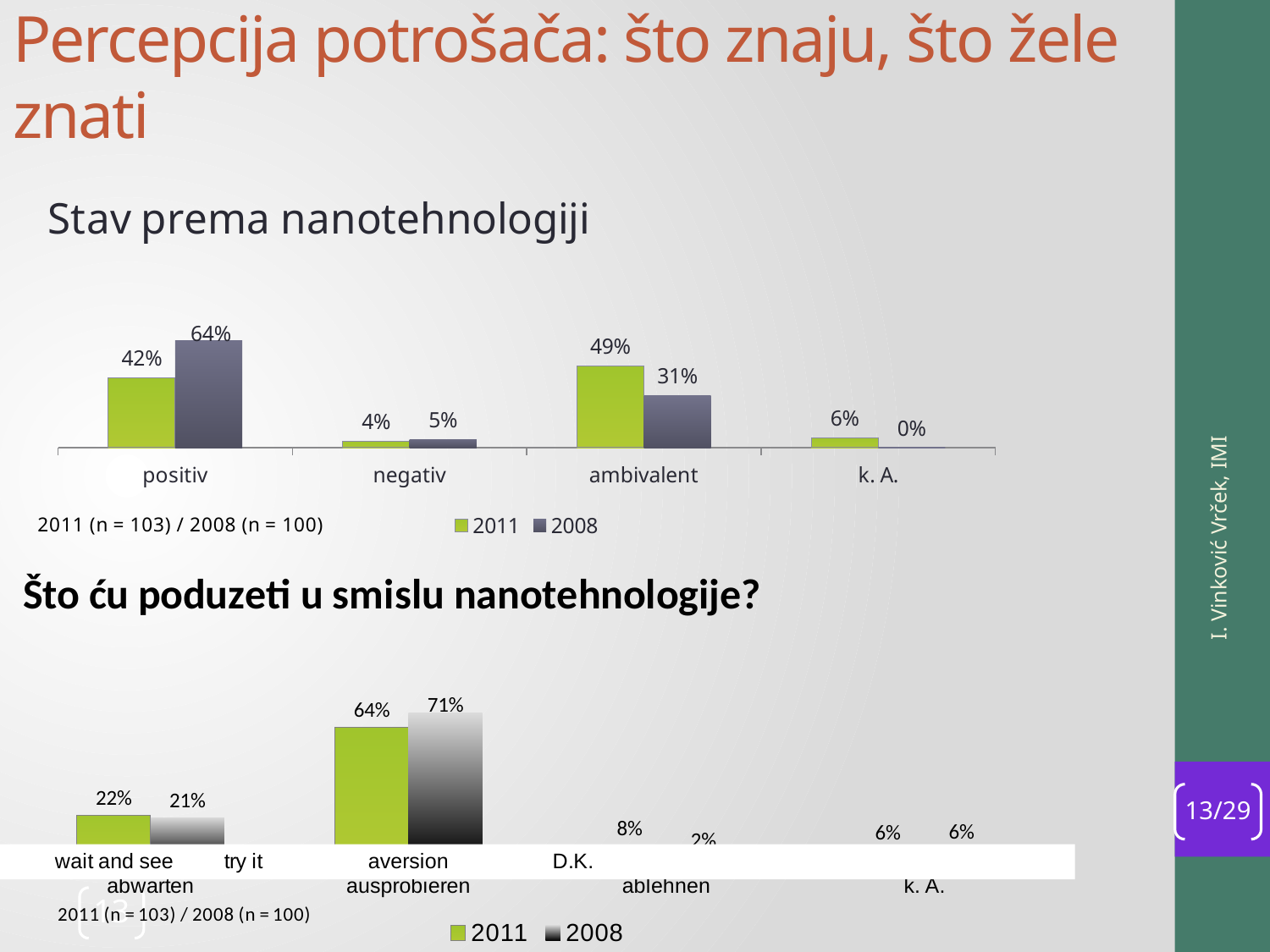
In the bottom chart (Što ću poduzeti u smislu nanotehnologije?), what is the 2008 value for ausprobieren (try it)? 71% In the top chart (Stav prema nanotehnologiji), what is the 2011 value for positiv? 42% In the top chart (Stav prema nanotehnologiji), how many categories are shown on the x axis? 4 In the top chart (Stav prema nanotehnologiji), which category has the highest 2008 value? positiv In the top chart (Stav prema nanotehnologiji), is the 2011 or the 2008 value larger for ambivalent? 2011 In the bottom chart (Što ću poduzeti u smislu nanotehnologije?), what is the difference between the 2008 and 2011 values for ausprobieren (try it)? 7% In the bottom chart (Što ću poduzeti u smislu nanotehnologije?), what is the 2011 value for abwarten (wait and see)? 22% In the top chart (Stav prema nanotehnologiji), what is the 2008 value for ambivalent? 31% In the top chart (Stav prema nanotehnologiji), how many series does the legend list? 2 What type of chart is the bottom chart (Što ću poduzeti u smislu nanotehnologije?)? bar chart In the top chart (Stav prema nanotehnologiji), which category has the lowest 2011 value? negativ In the top chart (Stav prema nanotehnologiji), what is the difference between the 2008 and 2011 values for positiv? 22%